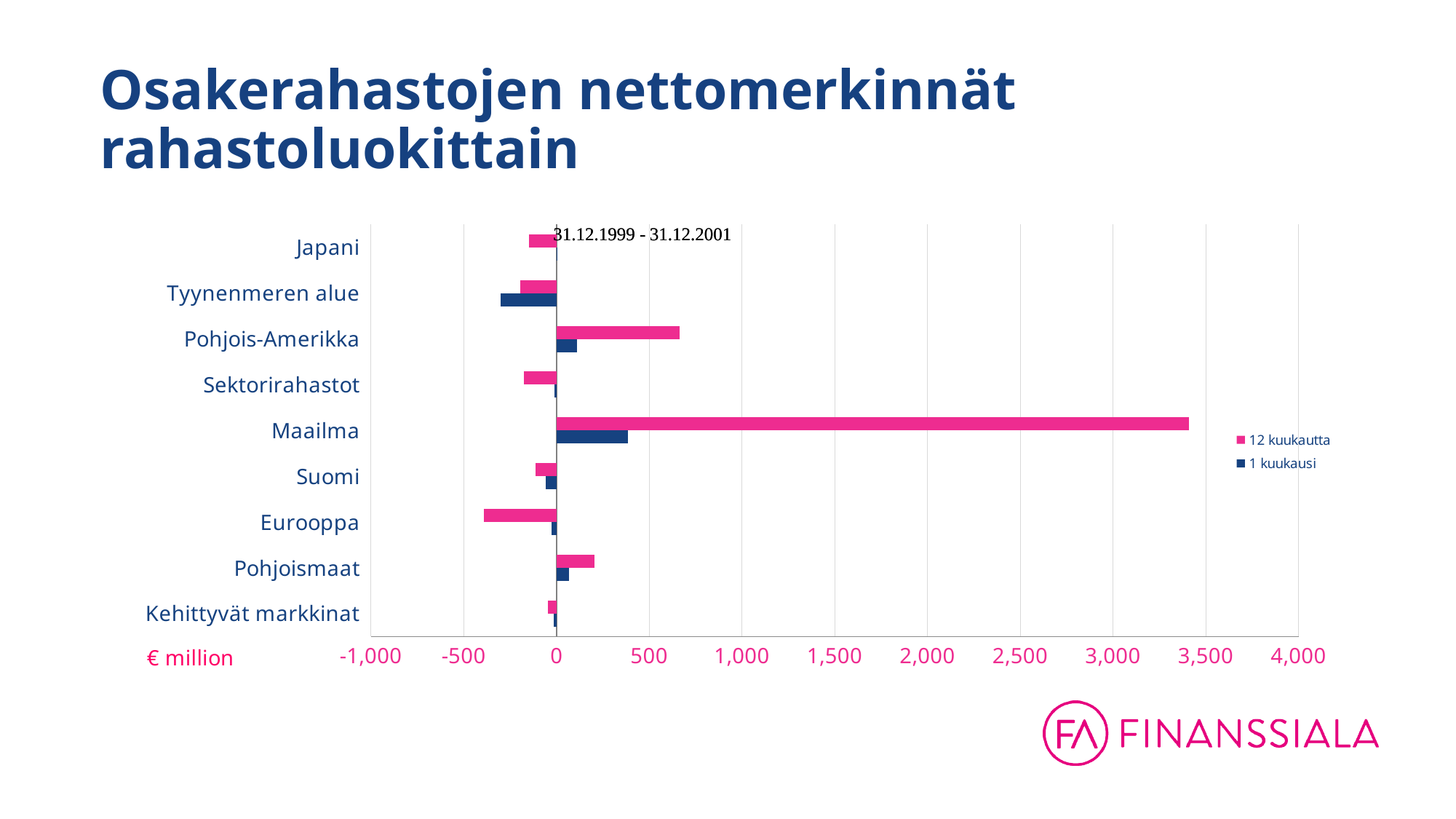
How many series does the chart's legend list? 2 Which category has the highest value for the 1 kuukausi series? Maailma Which category has the highest value for the 12 kuukautta series? Maailma Which is larger for the 12 kuukautta series: Pohjois-Amerikka or Pohjoismaat? Pohjois-Amerikka Is the 12 kuukautta value for Pohjois-Amerikka greater or less than 500? greater What kind of chart is shown on the slide? bar chart Is the 12 kuukautta value for Maailma greater or less than 3,000? greater How many fund categories are listed on the chart's vertical axis? 9 Is the 12 kuukautta value for Eurooppa greater or less than 0? less What are the two series named in the chart's legend? 12 kuukautta and 1 kuukausi Which category has the lowest value for the 12 kuukautta series? Eurooppa What unit is shown for the chart's horizontal axis? € million